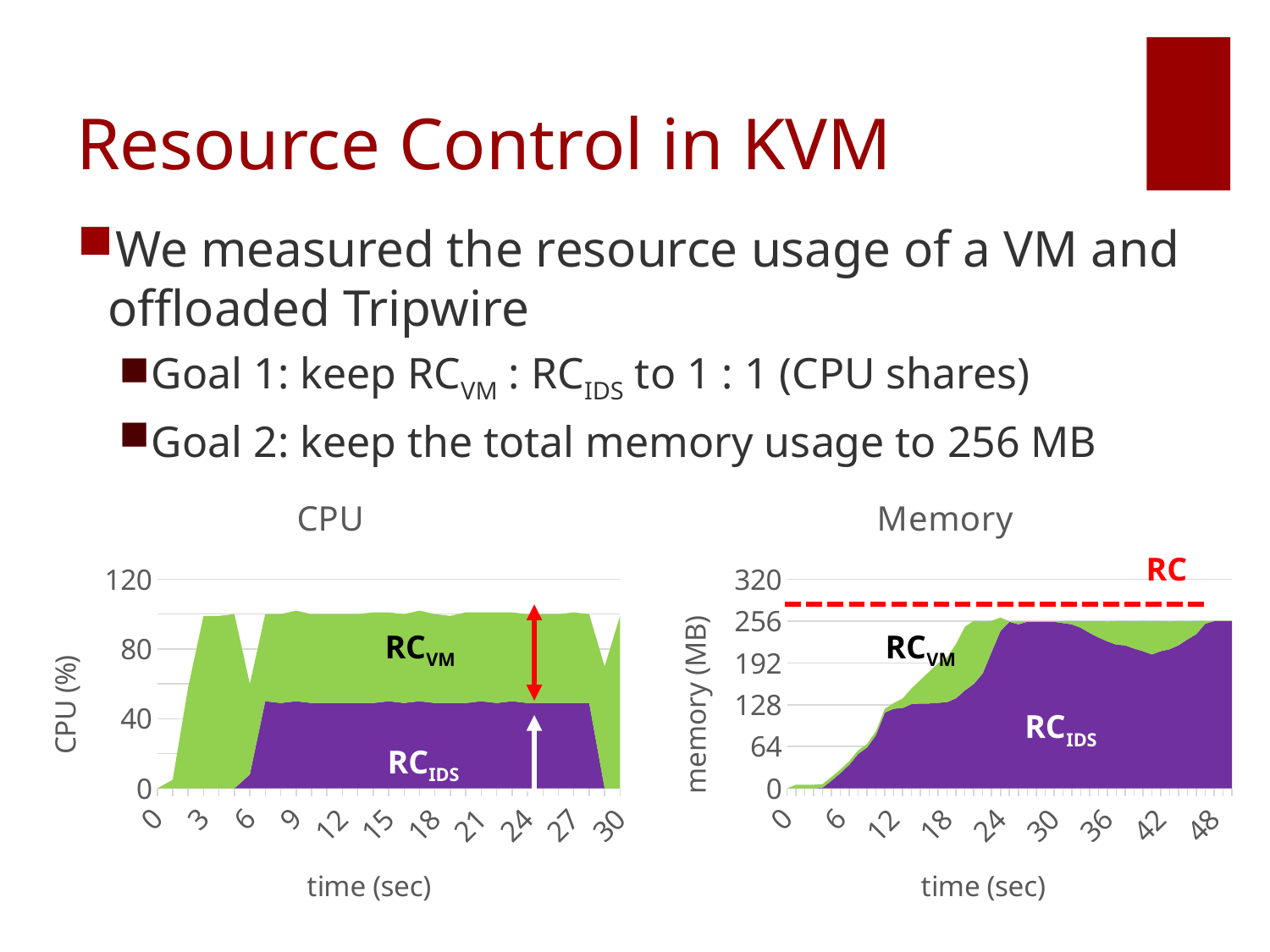
How many tick labels are shown on the x axis of the Memory chart? 9 In the CPU chart, is the value for RC_IDS at 3 seconds greater or less than 40? less What is the x-axis title of the CPU chart? time (sec) In the CPU chart, is the value for RC_IDS at 15 seconds greater or less than 40? greater In the Memory chart, is the total memory usage at 6 seconds greater or less than 64? less What kind of chart is the CPU chart on the left? area chart In the CPU chart, does the RC_IDS CPU usage rise or fall between 6 and 9 seconds? rise In the Memory chart, does the RC_IDS memory usage rise or fall between 0 and 24 seconds? rise What is the label of the red dashed line in the Memory chart? RC How many series are plotted in the Memory chart? 2